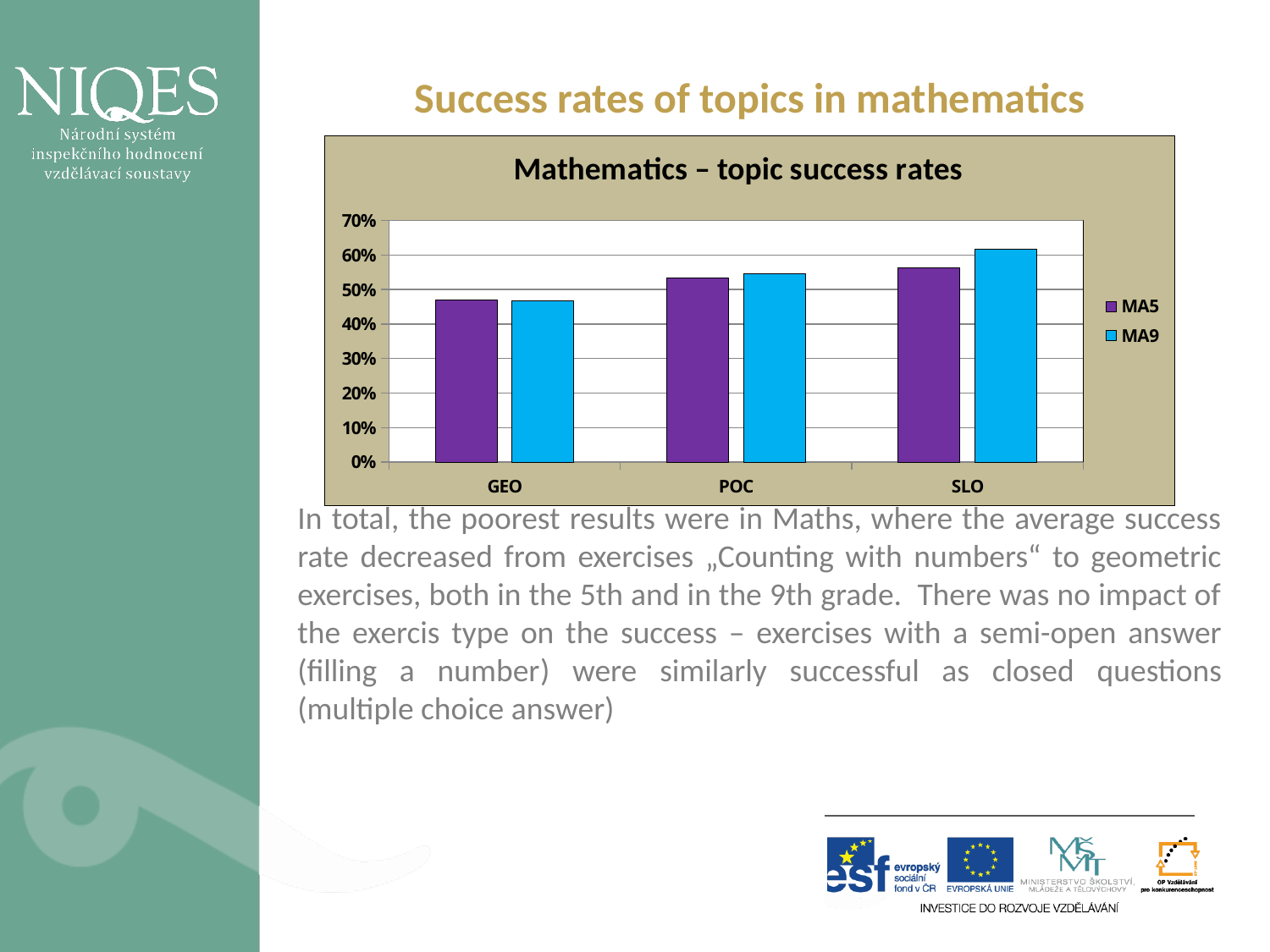
Is the MA5 value for POC greater or less than 50%? greater How many categories are shown on the x axis? 3 Which category has the highest MA9 value? SLO Which category has the lowest MA9 value? GEO Is the MA5 value for GEO greater or less than 50%? less Do the MA9 values rise or fall from GEO to SLO along the x axis? rise Is the MA9 value for SLO greater or less than 60%? greater What kind of chart is shown on the slide? bar chart What is the title of the chart? Mathematics – topic success rates How many series does the legend list? 2 Which category has the lowest MA5 value? GEO For SLO, which is larger, the MA5 value or the MA9 value? MA9